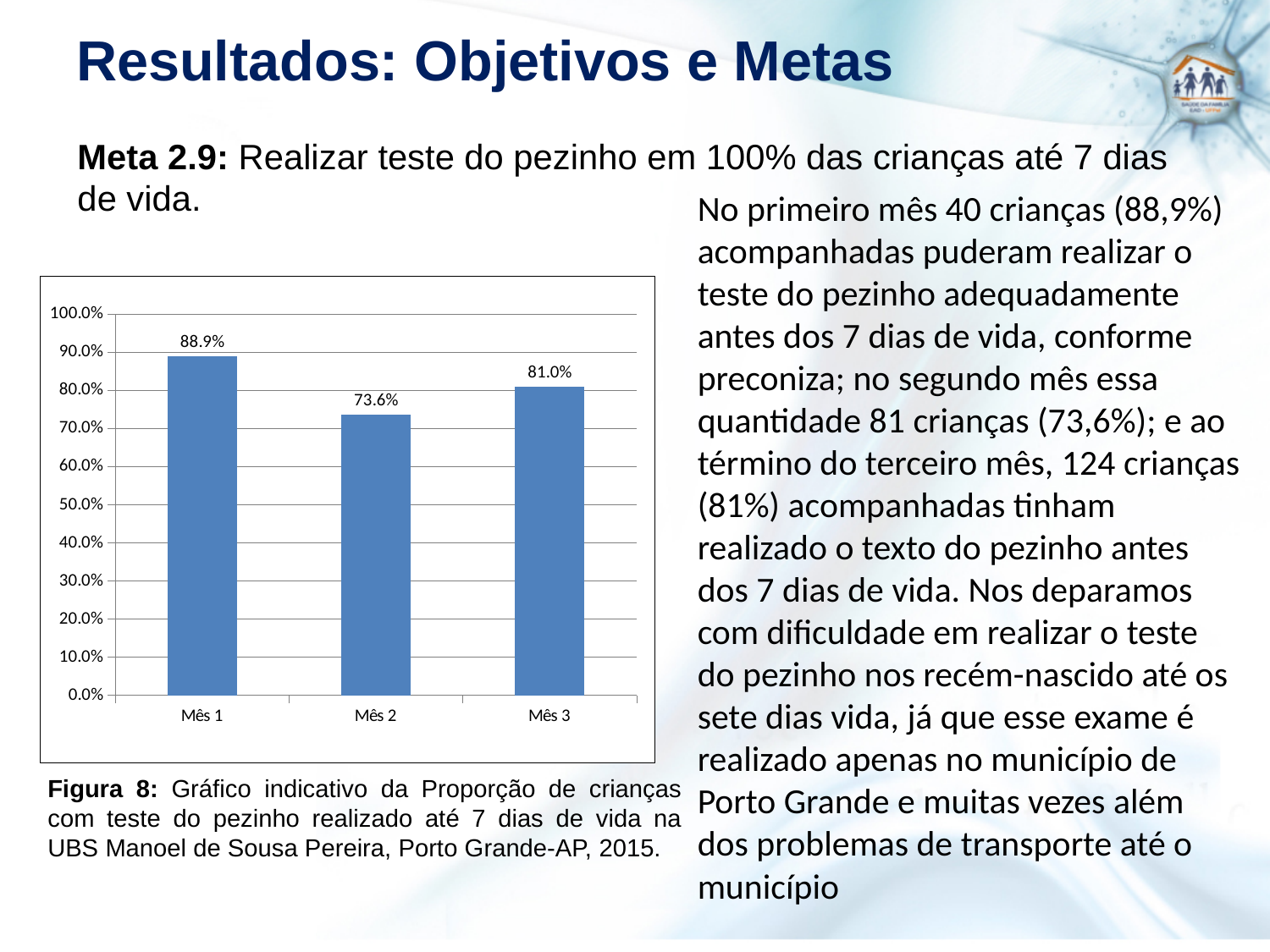
How many months are shown on the x axis? 3 What is the value for Mês 3? 81.0% What is the difference between the values for Mês 1 and Mês 2? 15.3% Which month has the lowest value? Mês 2 Which is larger, the value for Mês 2 or the value for Mês 3? Mês 3 Which month has the highest value? Mês 1 What is the difference between the values for Mês 3 and Mês 2? 7.4% What is the value for Mês 1? 88.9% What kind of chart is shown on the slide? bar chart What colour are the bars in the chart? blue Is the value for Mês 2 greater or less than 80.0%? less What is the value for Mês 2? 73.6%